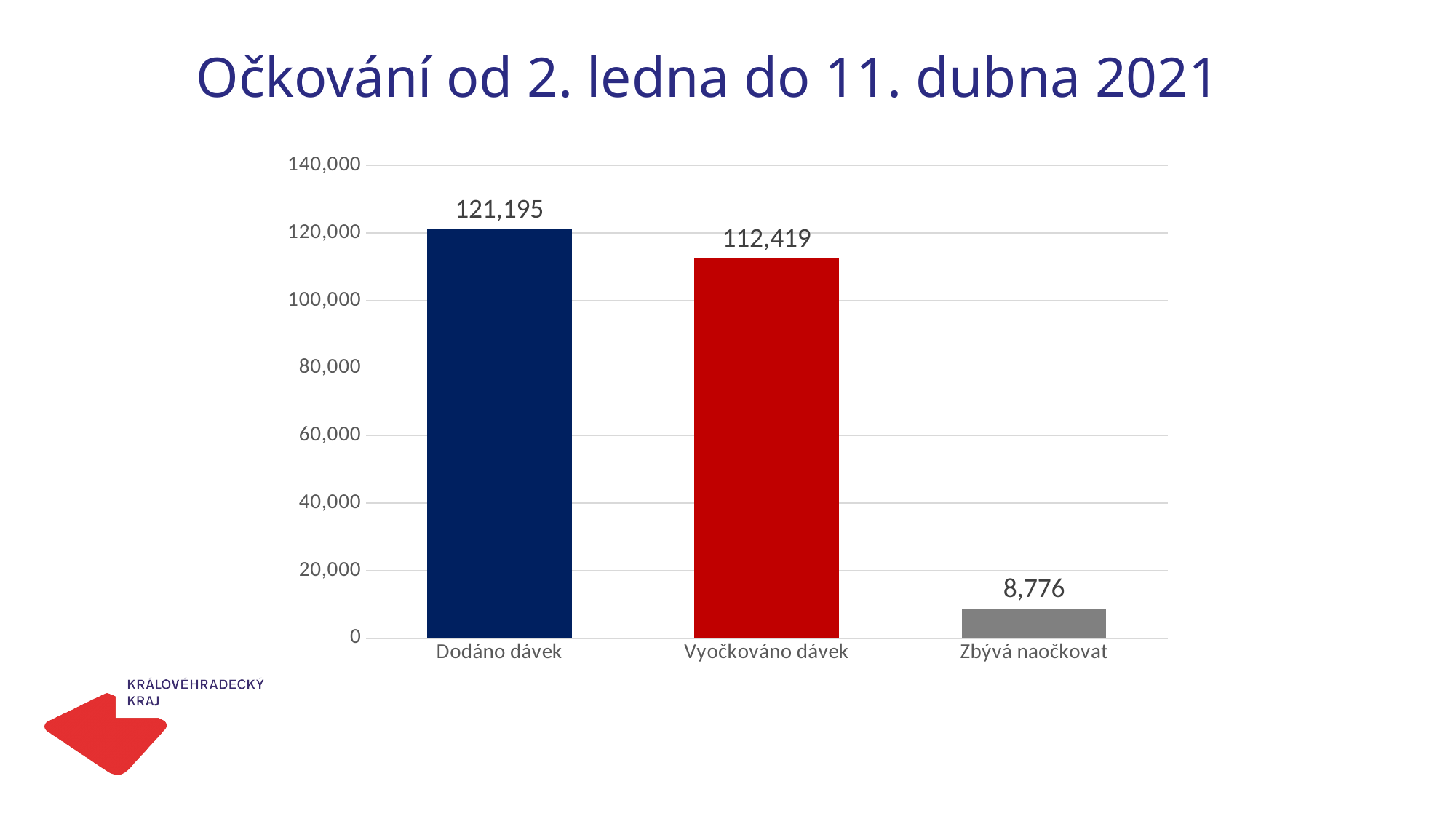
Is the value for Zbývá naočkovat greater or less than 20,000? less How many categories are shown in the chart? 3 What is the value for Zbývá naočkovat? 8,776 What is the title of the slide? Očkování od 2. ledna do 11. dubna 2021 What is the difference between Dodáno dávek and Vyočkováno dávek? 8,776 What is the value for Vyočkováno dávek? 112,419 What is the value for Dodáno dávek? 121,195 Which category has the highest value? Dodáno dávek Which is larger, Dodáno dávek or Vyočkováno dávek? Dodáno dávek Which category has the lowest value? Zbývá naočkovat What kind of chart is shown on the slide? bar chart What is the difference between Vyočkováno dávek and Zbývá naočkovat? 103,643